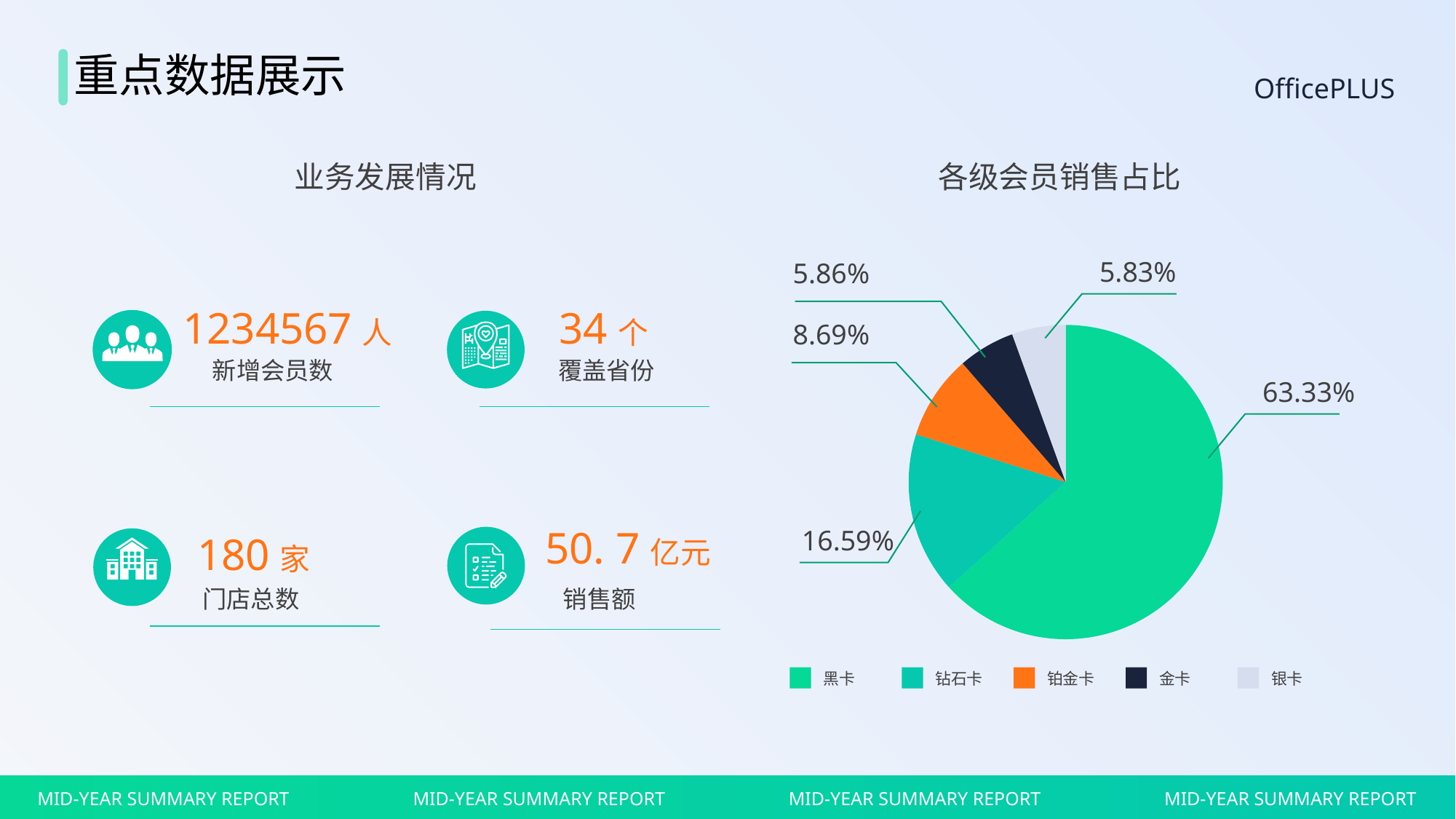
In the pie chart 各级会员销售占比, what share does 金卡 have? 5.86% In the pie chart 各级会员销售占比, what share does 黑卡 have? 63.33% In the pie chart 各级会员销售占比, what colour is the 铂金卡 slice? orange How many slices does the pie chart 各级会员销售占比 have? 5 In the pie chart 各级会员销售占比, which is larger, the share of 钻石卡 or the share of 铂金卡? 钻石卡 In the pie chart 各级会员销售占比, which membership level has the largest share? 黑卡 In the pie chart 各级会员销售占比, what share does 铂金卡 have? 8.69% In the pie chart 各级会员销售占比, what is the difference between the 钻石卡 share and the 铂金卡 share? 7.90% In the pie chart 各级会员销售占比, what share does 银卡 have? 5.83% In the pie chart 各级会员销售占比, how many percentage points larger is the 黑卡 share than the 钻石卡 share? 46.74% What kind of chart is shown under the title 各级会员销售占比? pie chart In the pie chart 各级会员销售占比, what share does 钻石卡 have? 16.59%